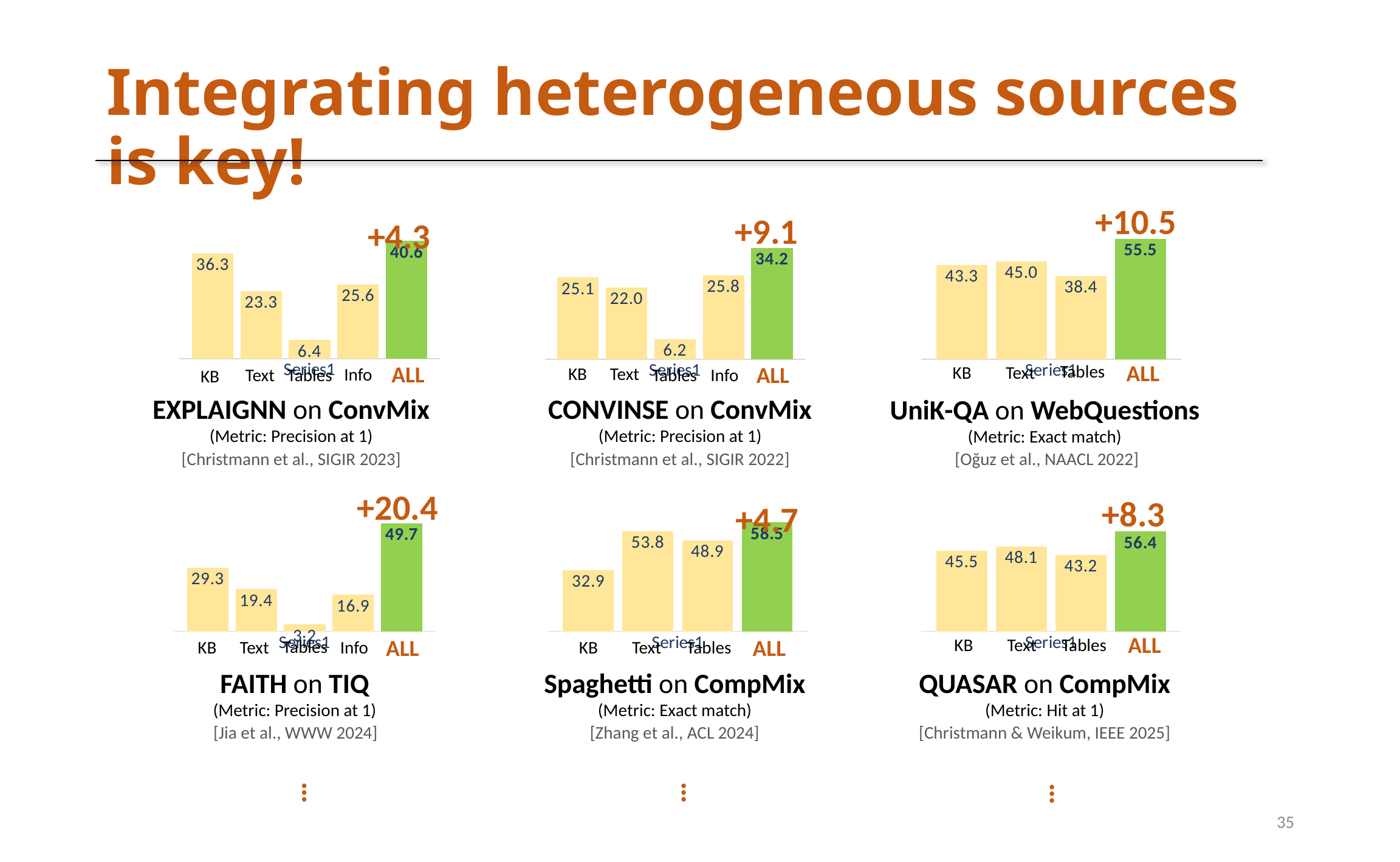
What type of chart is the FAITH on TIQ chart? Bar chart In the FAITH on TIQ chart, which category has the highest value? ALL In the UniK-QA on WebQuestions chart, which is larger, KB or Text? Text In the FAITH on TIQ chart, what is the value for Tables? 3.2 In the EXPLAIGNN on ConvMix chart, which category has the lowest value? Tables In the EXPLAIGNN on ConvMix chart, what is the value for KB? 36.3 In the UniK-QA on WebQuestions chart, how many bars are plotted? 4 In the CONVINSE on ConvMix chart, what is the value for ALL? 34.2 In the QUASAR on CompMix chart, what is the difference between the ALL value and the Tables value? 13.2 In the Spaghetti on CompMix chart, what is the value for Text? 53.8 In the Spaghetti on CompMix chart, which category has the lowest value? KB In the CONVINSE on ConvMix chart, what is the difference between the ALL value and the Info value? 8.4